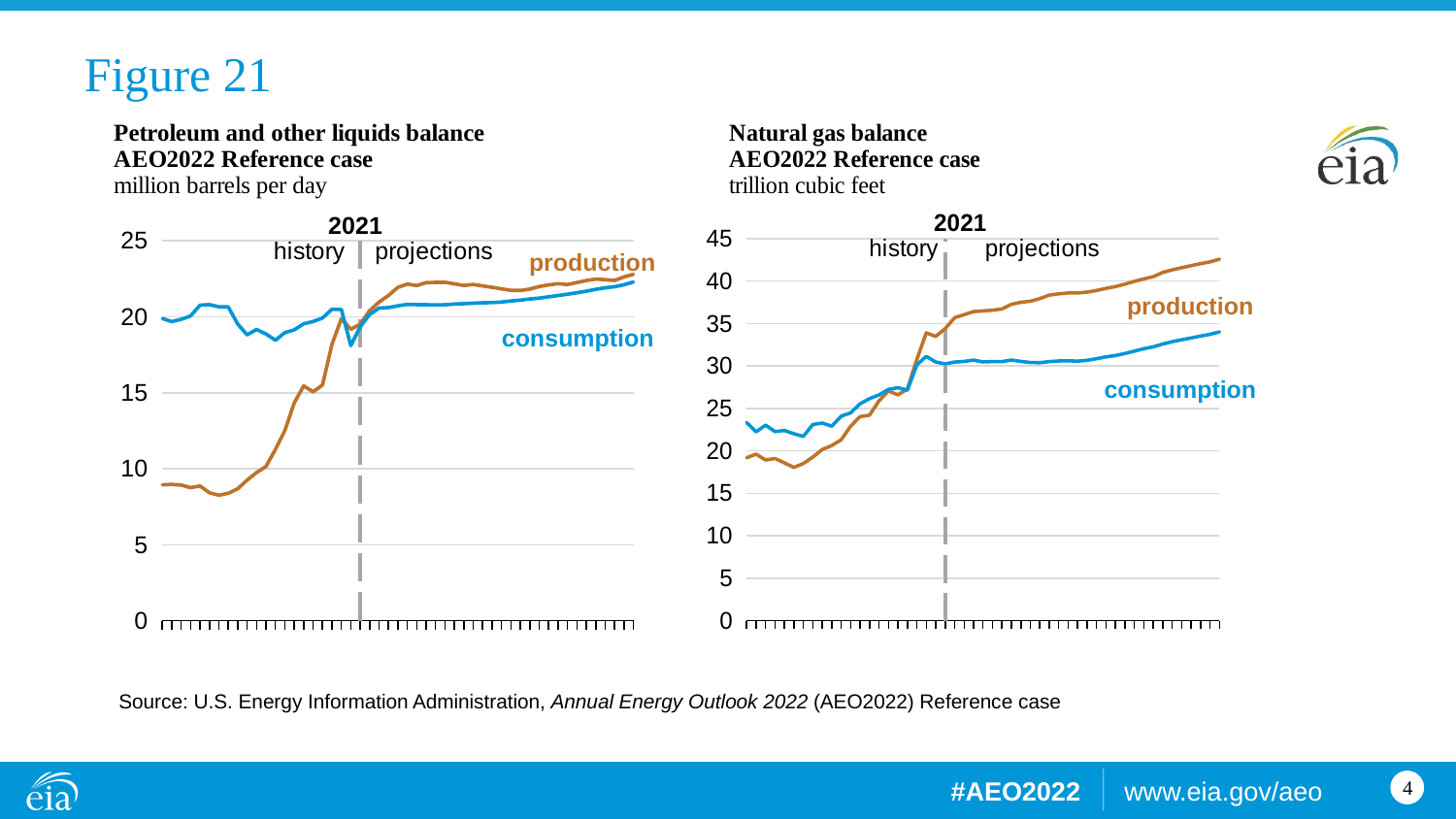
What kind of chart is the Petroleum and other liquids balance chart? line chart How many series are plotted on the Natural gas balance chart? 2 What kind of chart is the Natural gas balance chart? line chart In the Petroleum and other liquids balance chart, does the production line generally rise or fall from left to right? rise In the Natural gas balance chart, at the end of the projections, which is larger: production or consumption? production How many series are plotted on the Petroleum and other liquids balance chart? 2 In the Petroleum and other liquids balance chart, is the production value at the end of the projections greater or less than 20? greater In the Petroleum and other liquids balance chart, is the production value at the start of the series greater or less than 10? less What unit is used on the Natural gas balance chart? trillion cubic feet In the Natural gas balance chart, does the production line generally rise or fall from left to right? rise In the Natural gas balance chart, is the production value at the end of the projections greater or less than 40? greater